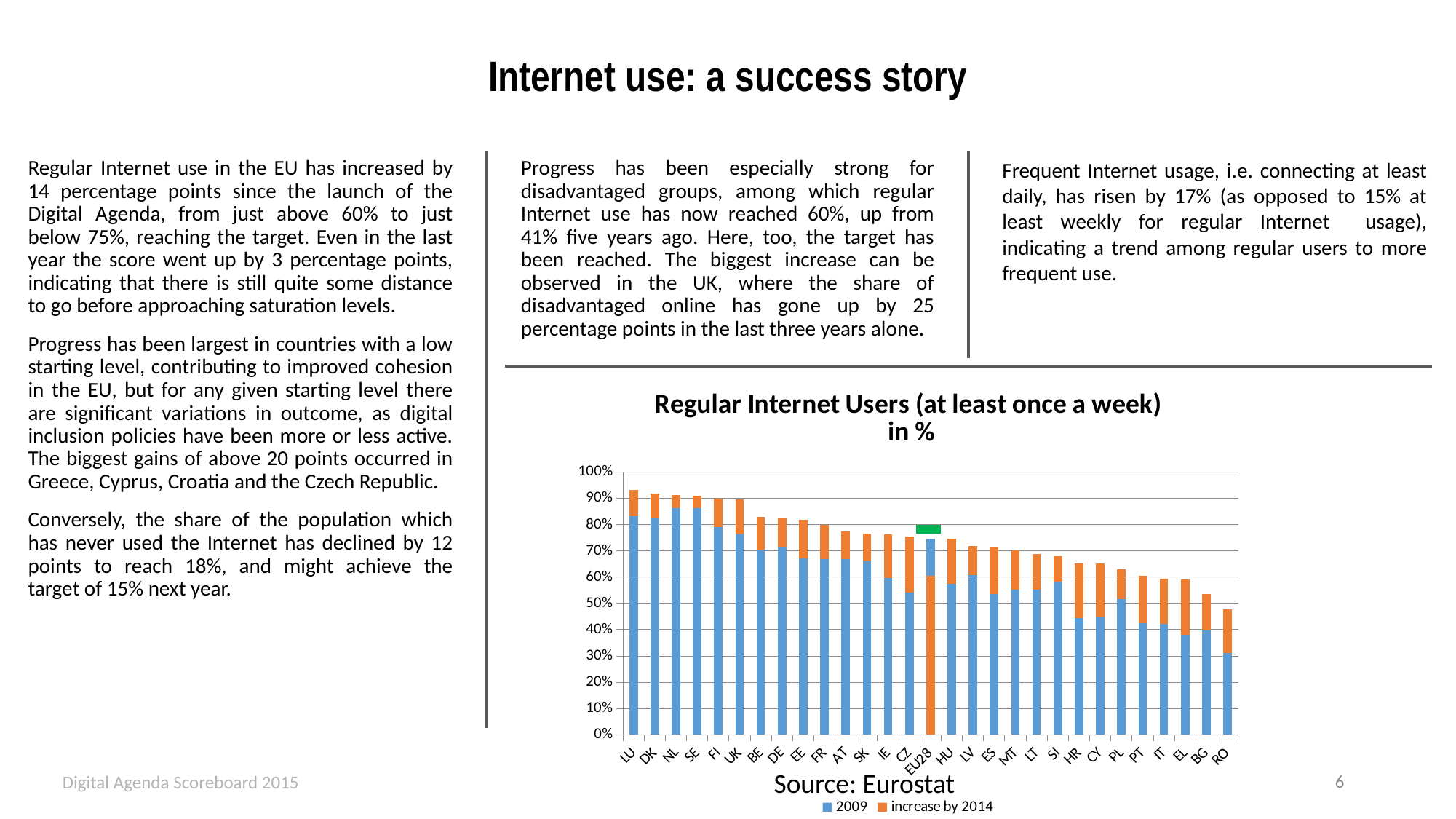
How many series does the chart's legend list? 2 What is the title of the chart? Regular Internet Users (at least once a week) in % Do the total bar heights generally rise or fall from left to right along the x axis? fall Which has the larger total bar, LU or RO? LU Is the total bar for RO greater or less than 50%? less What are the two series named in the legend? 2009 and increase by 2014 What kind of chart is shown on the slide? bar chart Is the 2009 value for NL greater or less than 80%? greater Is the total bar for LU greater or less than 90%? greater How many countries or regions are shown along the x axis of the chart? 29 Which category has the highest total bar in the chart? LU Which category has the lowest total bar in the chart? RO